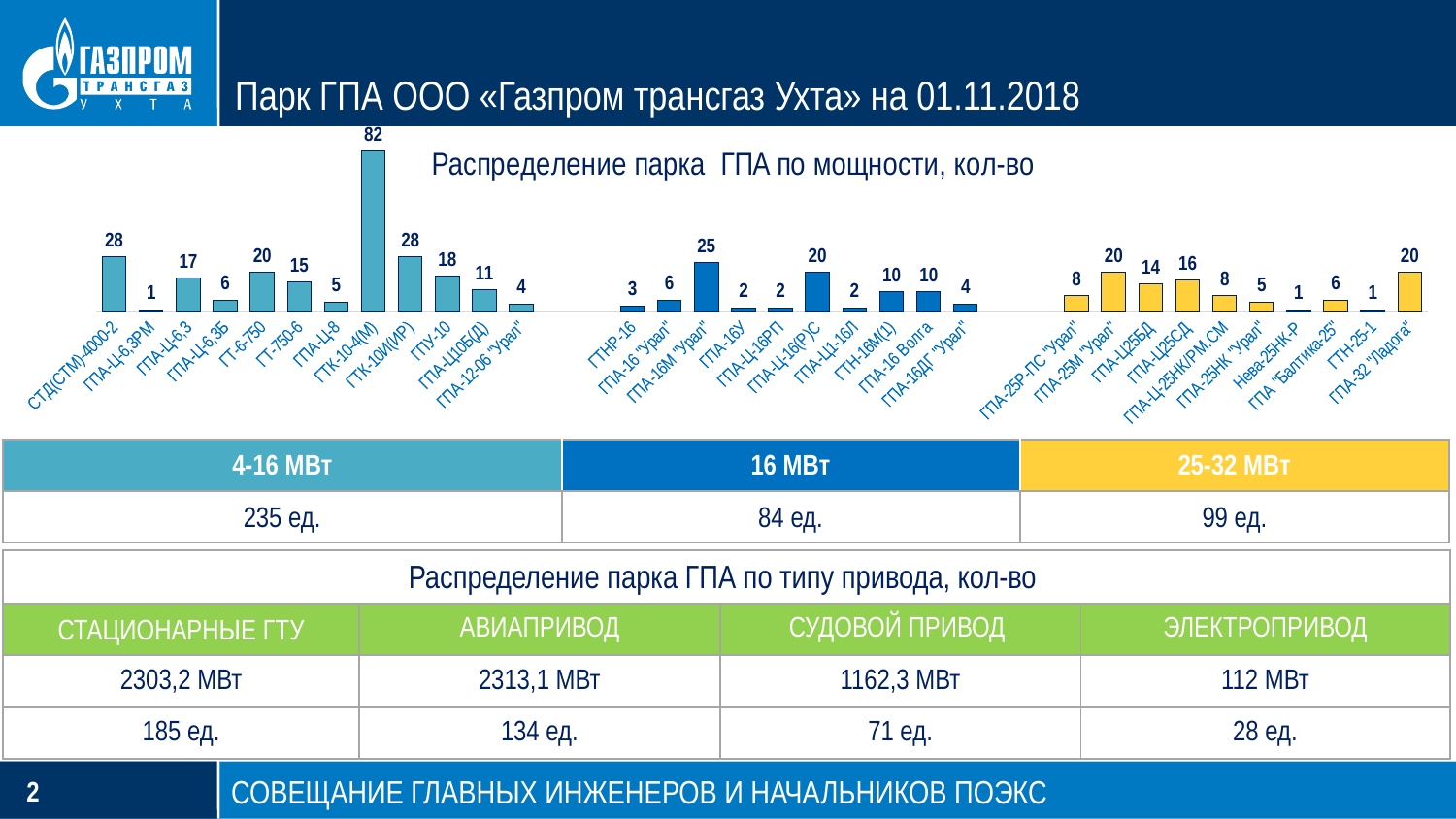
What is the value for ГПА-16М "Урал"? 25 What type of chart is shown on the slide? bar chart What is the value for ГТК-10-4(М)? 82 What is the difference between the values for ГТК-10-4(М) and ГТК-10И(ИР)? 54 Which category has the highest value in the chart? ГТК-10-4(М) What is the value for ГПУ-10? 18 What is the title of the chart on the slide? Распределение парка ГПА по мощности, кол-во How many bars are shown in the yellow (25-32 МВт) group of the chart? 10 How many different bar colours are used in the chart? 3 What is the value for ГПА-32 "Ладога"? 20 What is the value for ГТ-6-750? 20 Which is larger, the value for ГПА-Ц-6,3 or the value for ГПА-Ц-6,3Б? ГПА-Ц-6,3